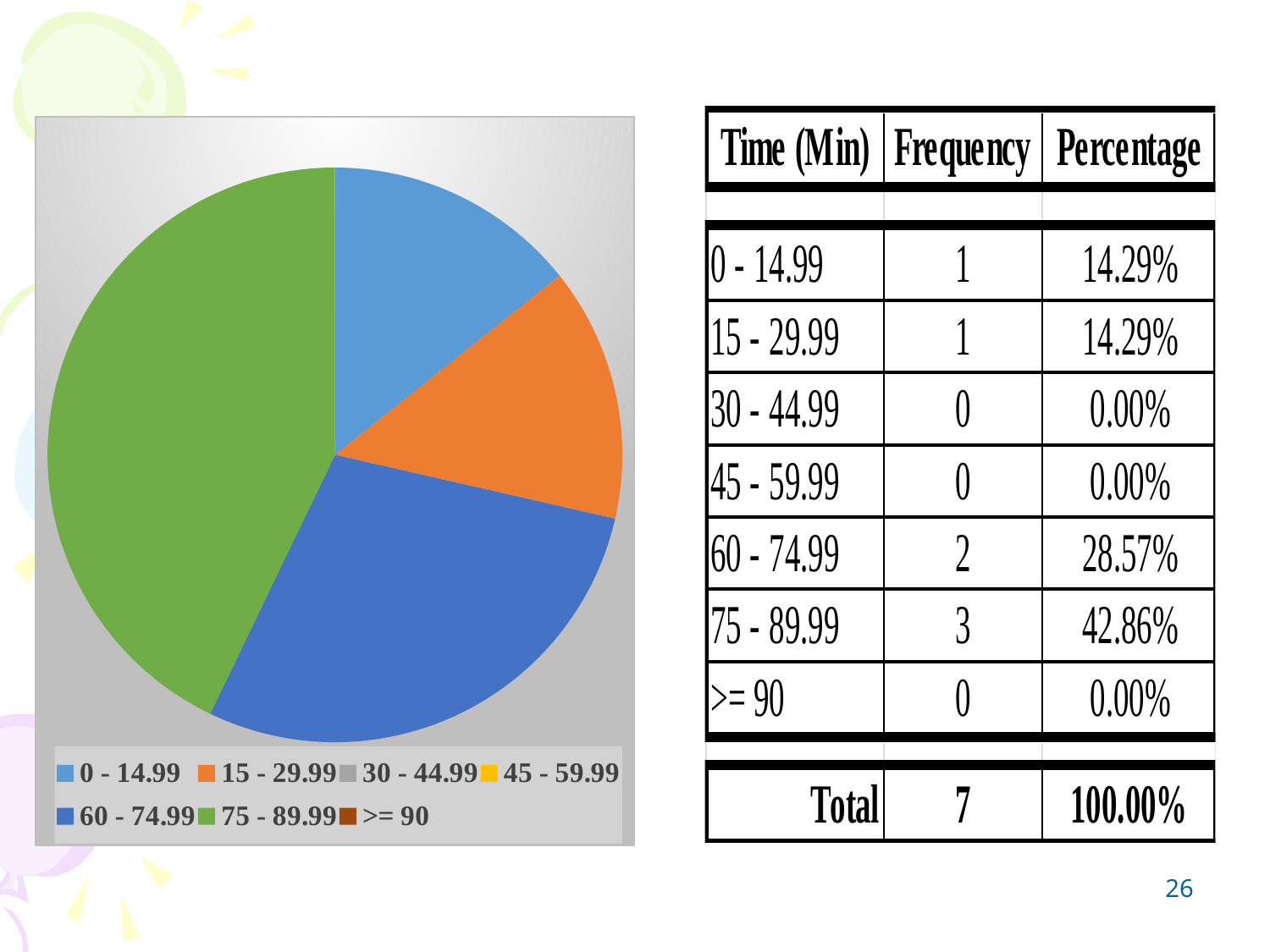
How many categories does the pie chart's legend list? 7 What percentage is shown for the 60 - 74.99 time category? 28.57% What is the total frequency across all time categories? 7 Which slice is larger in the pie chart: 60 - 74.99 or 15 - 29.99? 60 - 74.99 What colour is the 75 - 89.99 slice in the pie chart? green What share of the pie does the 0 - 14.99 category represent? 14.29% What is the frequency for the 75 - 89.99 time category? 3 What kind of chart is shown on the left of the slide? pie chart How many time categories have a frequency of 0? 3 Which time category has the largest slice of the pie chart? 75 - 89.99 What is the difference in frequency between the 75 - 89.99 and 60 - 74.99 categories? 1 What colour does the legend assign to the >= 90 category? brown